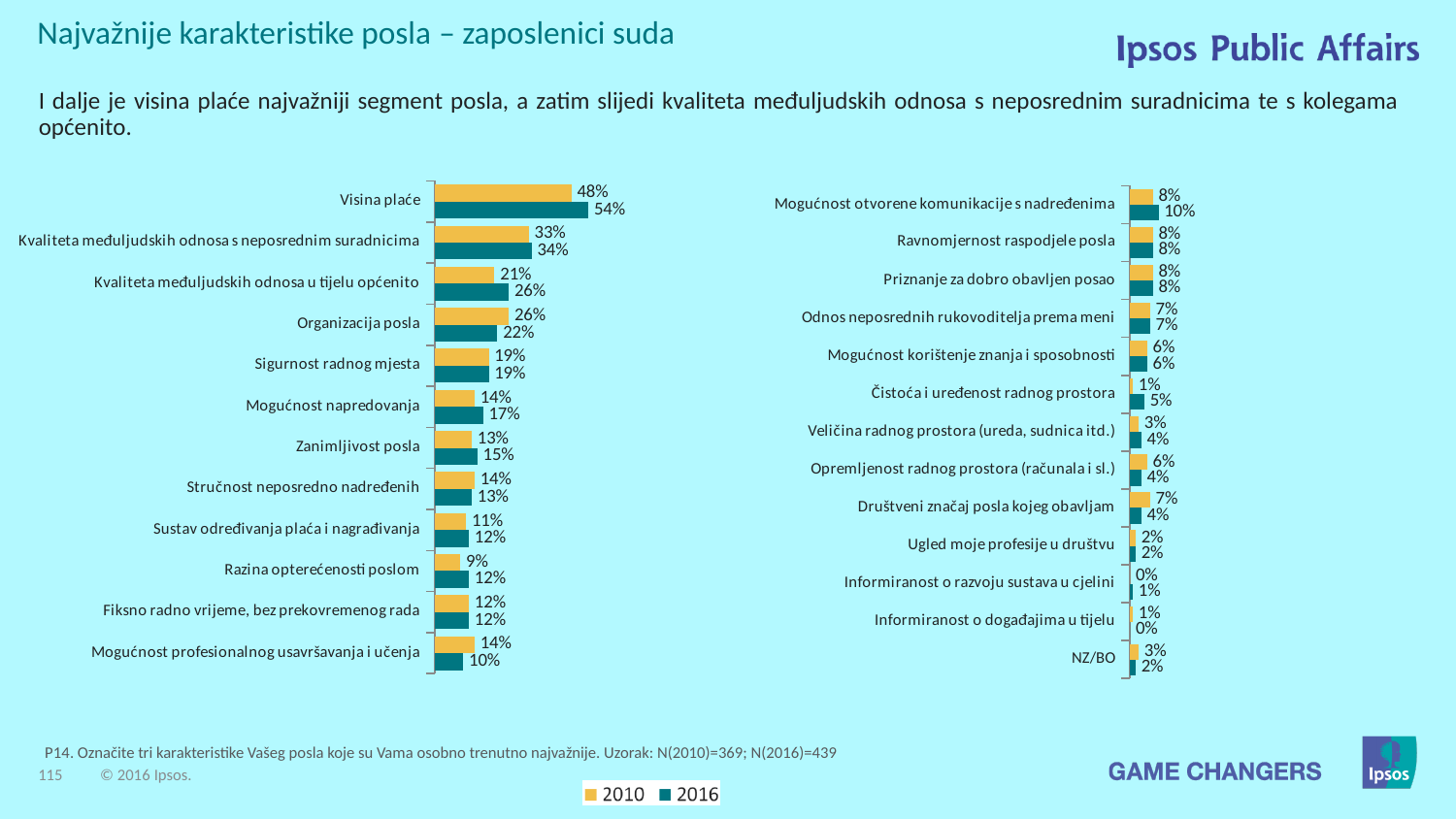
What type of chart is the left chart? Bar chart On the right chart, which category has the highest 2016 value? Mogućnost otvorene komunikacije s nadređenima On the left chart, what is the 2010 value for Organizacija posla? 26% On the right chart, what is the 2016 value for Čistoća i uređenost radnog prostora? 5% On the left chart, what is the 2016 value for Visina plaće? 54% How many categories are shown on the right chart? 13 On the left chart, which is larger for Mogućnost profesionalnog usavršavanja i učenja: the 2010 value or the 2016 value? 2010 On the right chart, which is larger for Društveni značaj posla kojeg obavljam: the 2010 value or the 2016 value? 2010 How many categories are shown on the left chart? 12 How many series does the legend list? 2 On the left chart, which category has the highest 2016 value? Visina plaće On the left chart, what is the difference between the 2016 and 2010 values for Visina plaće? 6 percentage points